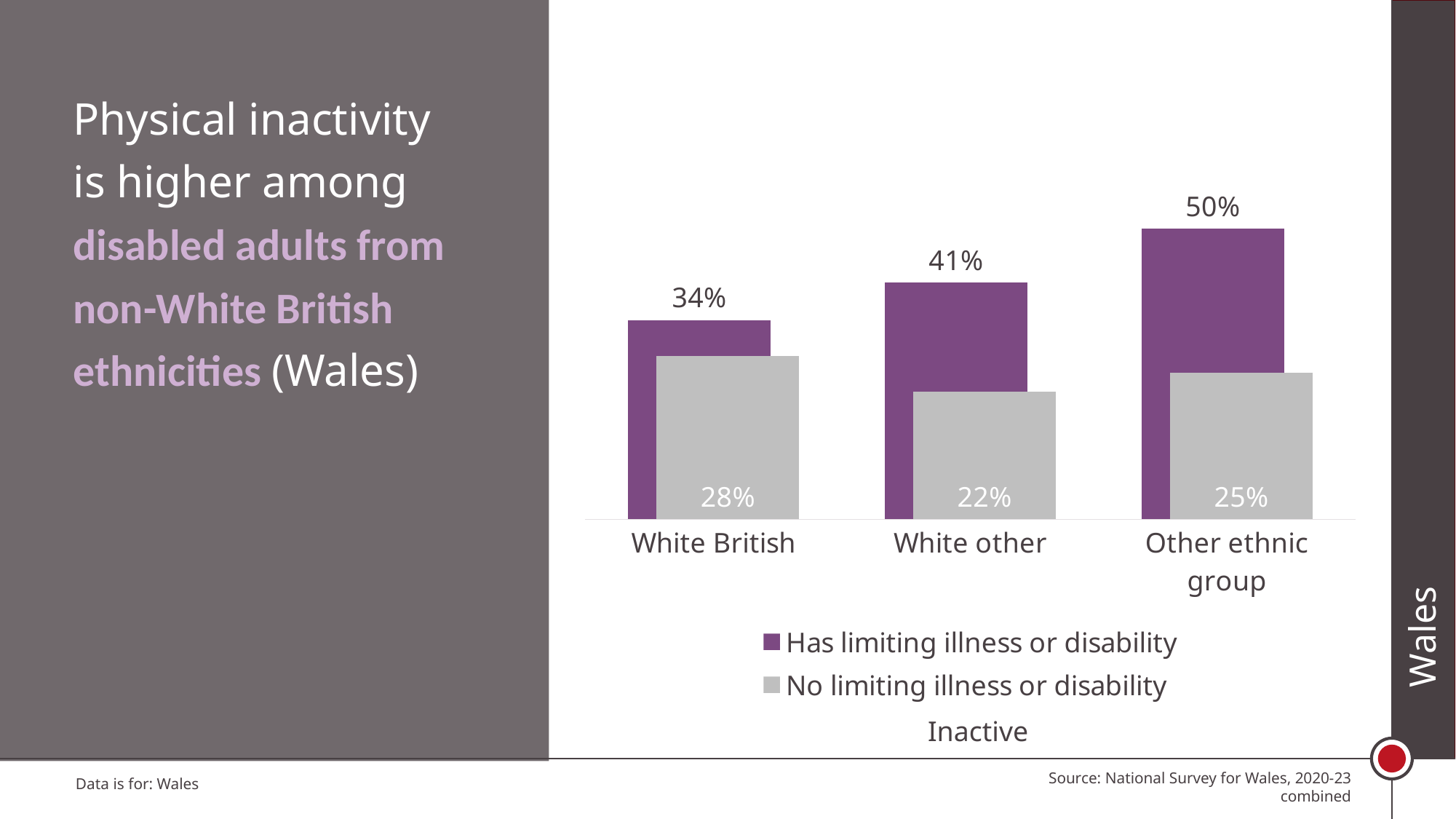
What is the value for the Other ethnic group with a limiting illness or disability? 50% Which ethnic group has the highest inactivity rate among those with a limiting illness or disability? Other ethnic group Which colour represents 'Has limiting illness or disability' in the legend? Purple How many series does the legend list? 2 What is the value for White other adults with no limiting illness or disability? 22% Which is larger: the 'No limiting illness or disability' value for White British or for Other ethnic group? White British How many ethnic group categories are shown on the x axis? 3 What is the difference between the 'Has limiting illness or disability' values for White other and White British? 7% What is the difference between the 'Has limiting illness or disability' and 'No limiting illness or disability' values for the Other ethnic group? 25% Which ethnic group has the lowest inactivity rate among those with no limiting illness or disability? White other What is the value for White British adults who have a limiting illness or disability? 34% What kind of chart is shown on the slide? Bar chart